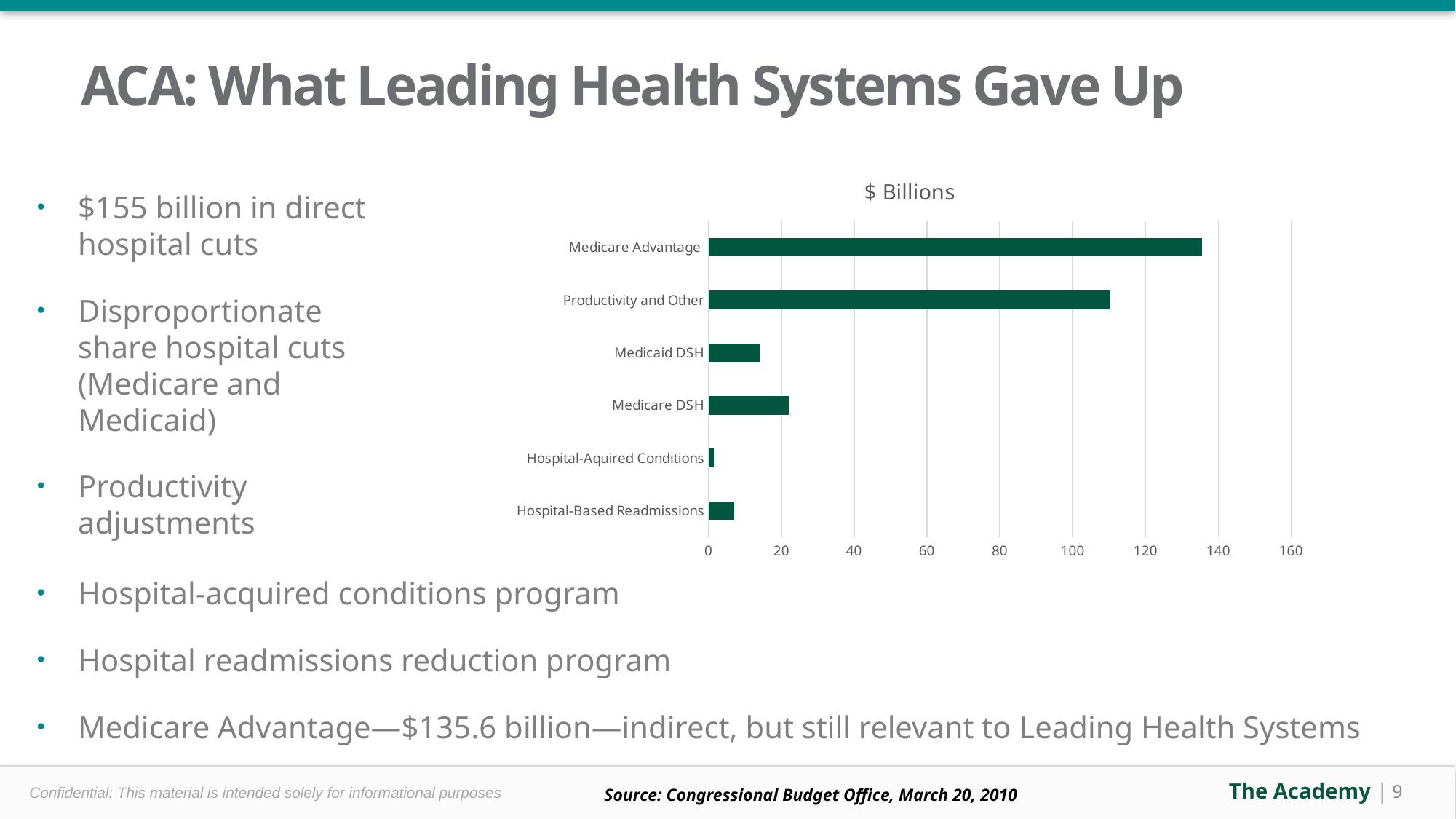
Is the value for Productivity and Other greater or less than 100? greater Which category has the lowest value in the chart? Hospital-Aquired Conditions Which is larger, the value for Productivity and Other or the value for Medicare Advantage? Medicare Advantage What is the highest value shown on the chart's horizontal axis? 160 Which is larger, the value for Medicare DSH or the value for Medicaid DSH? Medicare DSH What kind of chart is shown on the slide? bar chart What is the title of the chart? $ Billions Is the value for Medicaid DSH greater or less than 20? less Is the value for Hospital-Based Readmissions greater or less than 20? less Which category has the highest value in the chart? Medicare Advantage How many categories are plotted in the chart? 6